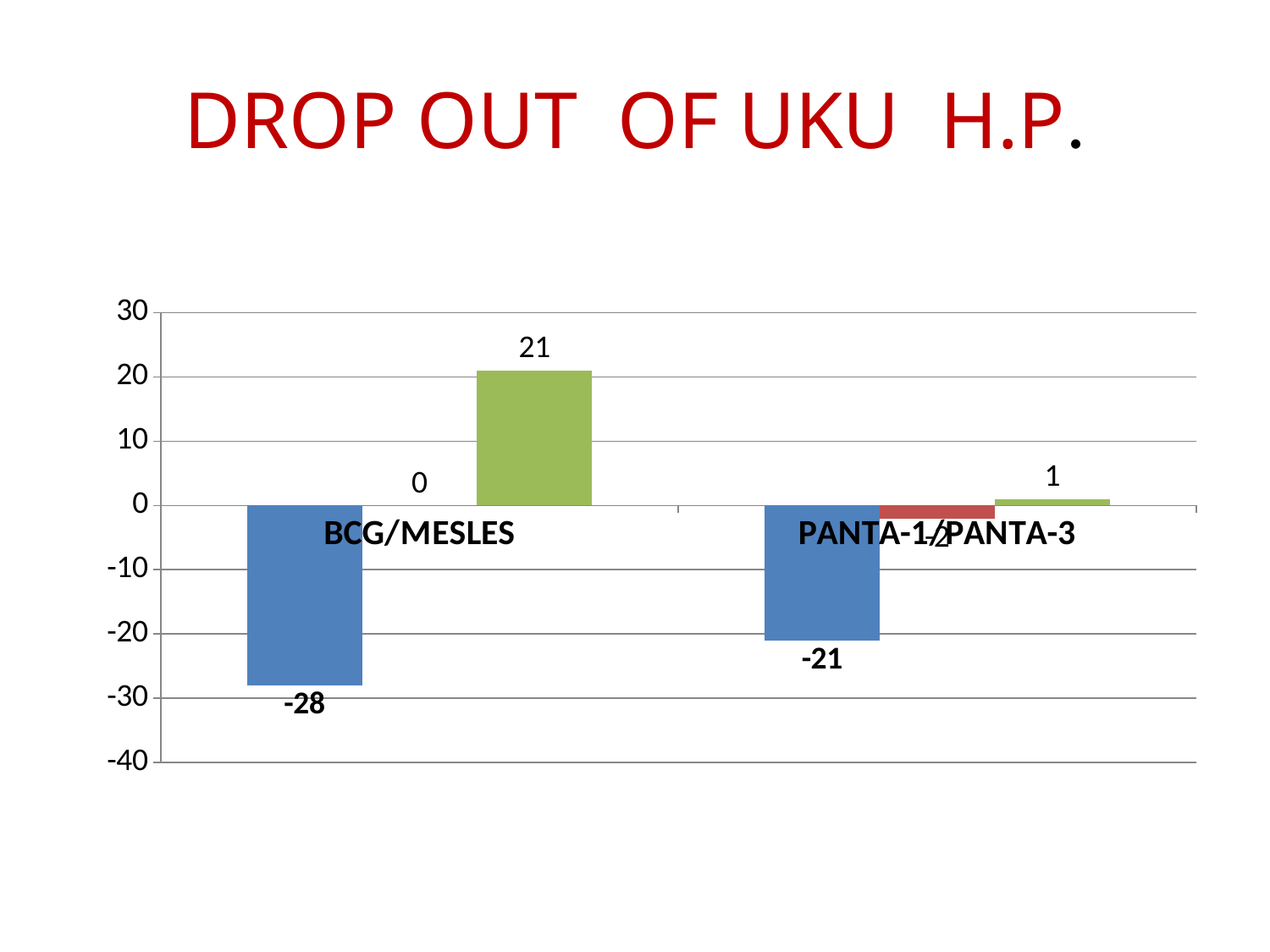
What is the value of the blue bar for BCG/MESLES? -28 What is the value of the green bar for BCG/MESLES? 21 What is the value of the red bar for BCG/MESLES? 0 What is the value of the green bar for PANTA-1/PANTA-3? 1 Which bar has the highest value on the chart? The green bar for BCG/MESLES (21) What is the title of the slide? DROP OUT OF UKU H.P. Which bar has the lowest value on the chart? The blue bar for BCG/MESLES (-28) Which is larger, the blue bar for BCG/MESLES or the blue bar for PANTA-1/PANTA-3? PANTA-1/PANTA-3 What is the value of the blue bar for PANTA-1/PANTA-3? -21 What type of chart is shown on the slide? Bar chart How many categories are shown on the x axis? 2 What is the difference between the green bar values for BCG/MESLES and PANTA-1/PANTA-3? 20